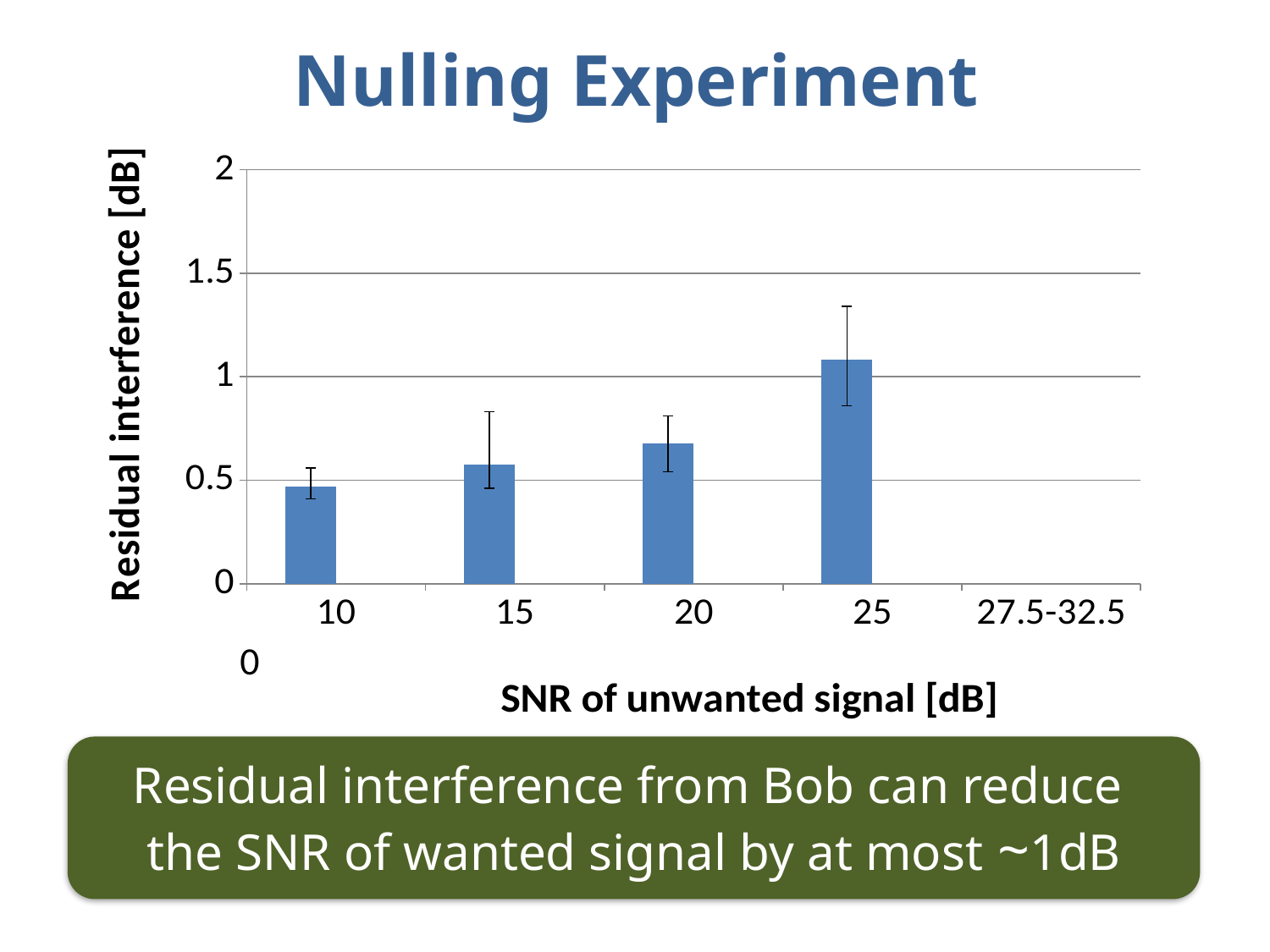
What kind of chart is shown on the slide? bar chart Is the residual interference for SNR 15 greater or less than 0.5? greater How many bars are plotted in the chart? 4 Which SNR of unwanted signal category has the lowest residual interference? 10 Which SNR of unwanted signal category has the highest residual interference? 25 Does the residual interference rise or fall as the SNR of the unwanted signal increases from 10 to 25? rise What is the label of the y axis? Residual interference [dB] Which has a larger residual interference, SNR 25 or SNR 10? 25 Which has a larger residual interference, SNR 20 or SNR 15? 20 Is the residual interference for SNR 25 greater or less than 1.5? less Is the residual interference for SNR 20 greater or less than 1? less